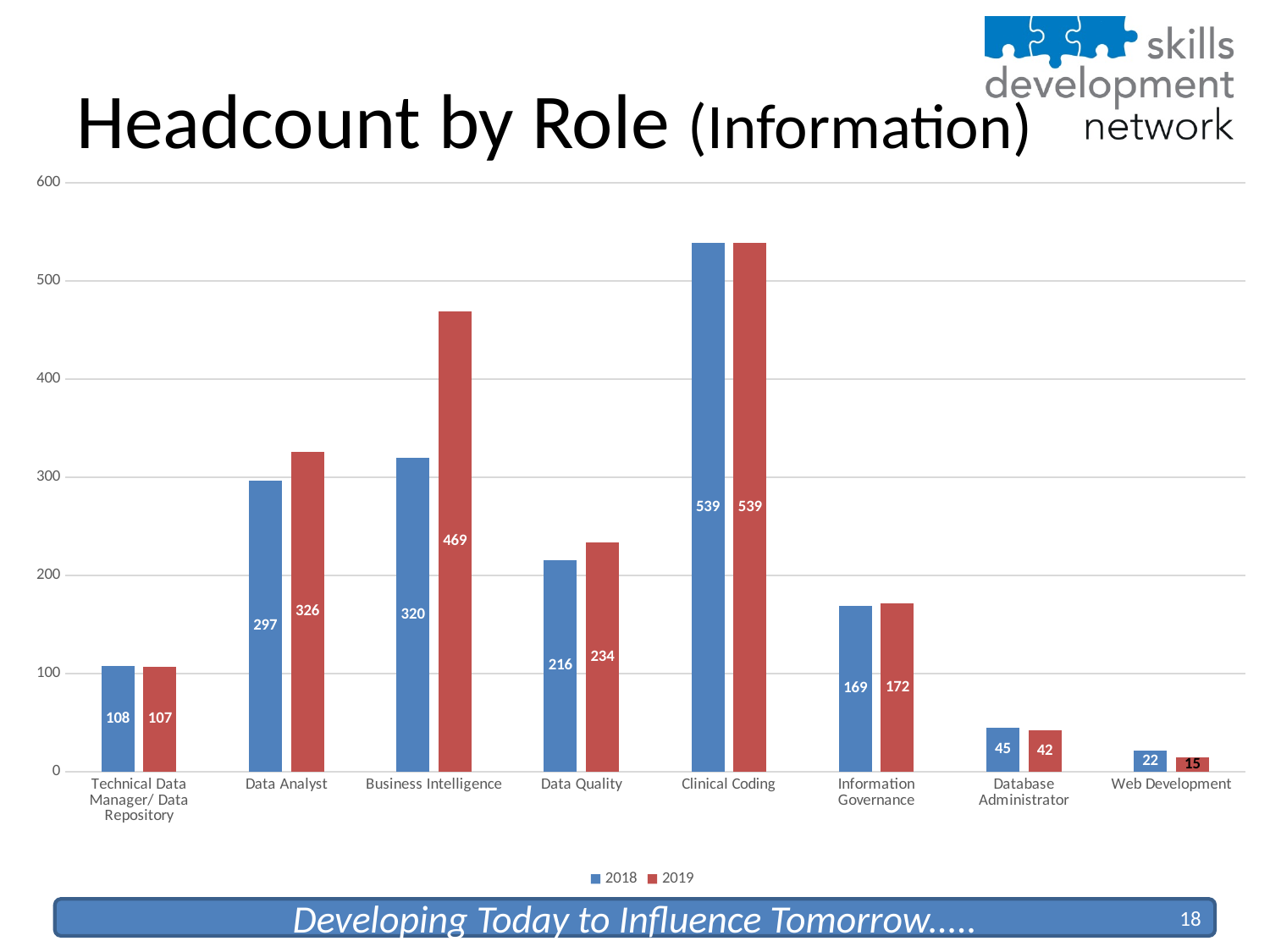
Is the 2019 headcount for Business Intelligence greater or less than 400? greater What is the title of the chart? Headcount by Role (Information) Which role has the highest headcount in 2019? Clinical Coding What is the 2019 headcount for Web Development? 15 How many roles are shown on the x axis? 8 What kind of chart is shown on the slide? bar chart How many series does the legend list? 2 What is the 2019 headcount for Business Intelligence? 469 What is the 2018 headcount for Data Quality? 216 Which role has the lowest headcount in 2018? Web Development Which is larger for Database Administrator, the 2018 or the 2019 headcount? 2018 What is the difference between the 2019 and 2018 headcount for Data Analyst? 29